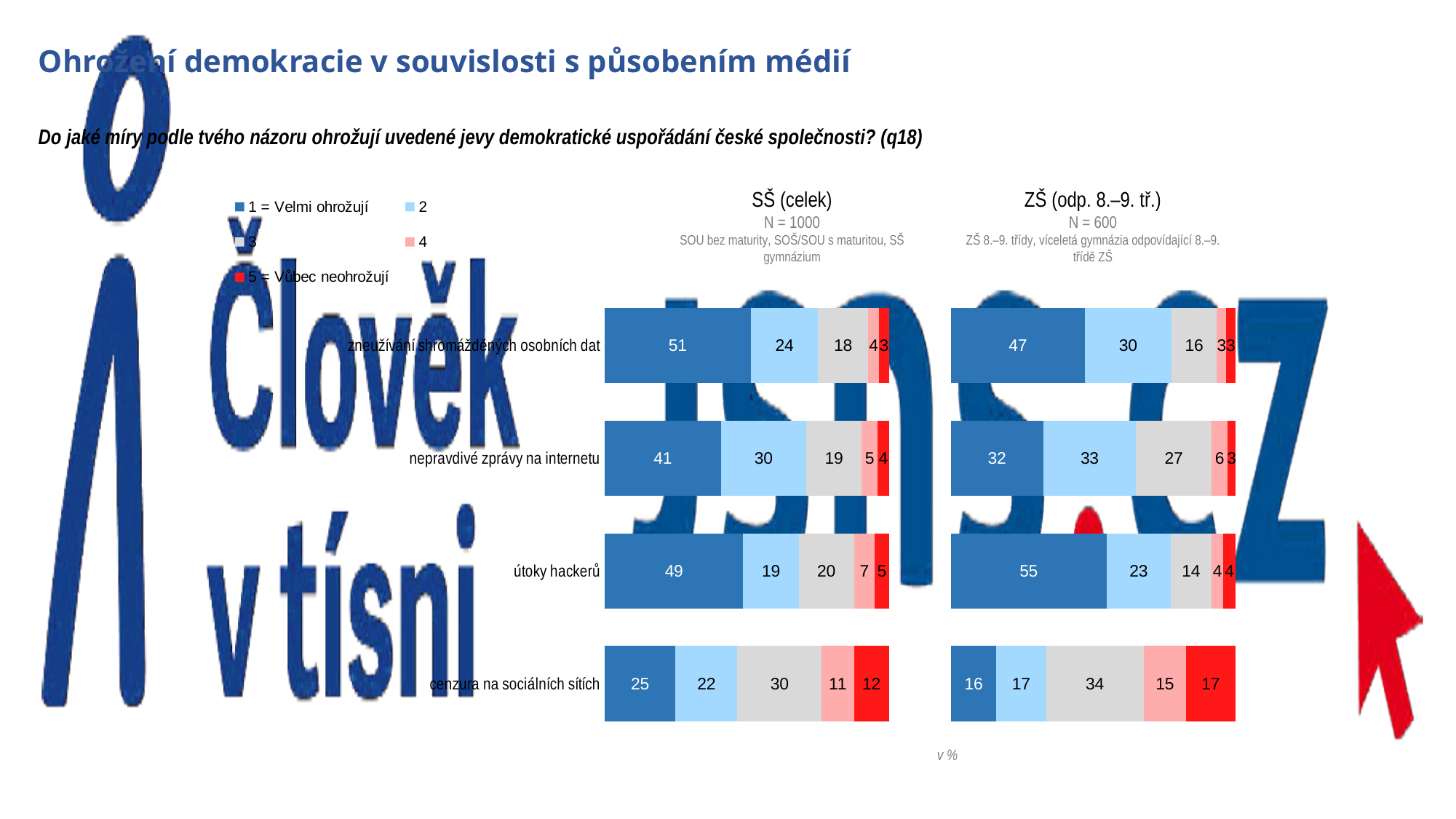
How many categories are shown in the SŠ (celek) chart? 4 In the SŠ (celek) chart, what is the difference between the "1 = Velmi ohrožují" values for "útoky hackerů" and "cenzura na sociálních sítích"? 24 What is the sample size (N) stated for the SŠ (celek) chart? N = 1000 Which is larger: the "1 = Velmi ohrožují" value for "útoky hackerů" in the SŠ (celek) chart or in the ZŠ (odp. 8.–9. tř.) chart? ZŠ (odp. 8.–9. tř.) In the ZŠ (odp. 8.–9. tř.) chart, what is the value of "5 = Vůbec neohrožují" for "cenzura na sociálních sítích"? 17 What kind of chart is the ZŠ (odp. 8.–9. tř.) chart? stacked bar chart In the ZŠ (odp. 8.–9. tř.) chart, what is the total of the stacked bar for "útoky hackerů"? 100 In the ZŠ (odp. 8.–9. tř.) chart, which category has the lowest value for "1 = Velmi ohrožují"? cenzura na sociálních sítích In the ZŠ (odp. 8.–9. tř.) chart, what is the value of series "3" for "nepravdivé zprávy na internetu"? 27 In the SŠ (celek) chart, which category has the highest value for "1 = Velmi ohrožují"? zneužívání shromážděných osobních dat In the SŠ (celek) chart, what is the value of "1 = Velmi ohrožují" for "zneužívání shromážděných osobních dat"? 51 How many series does the legend list? 5